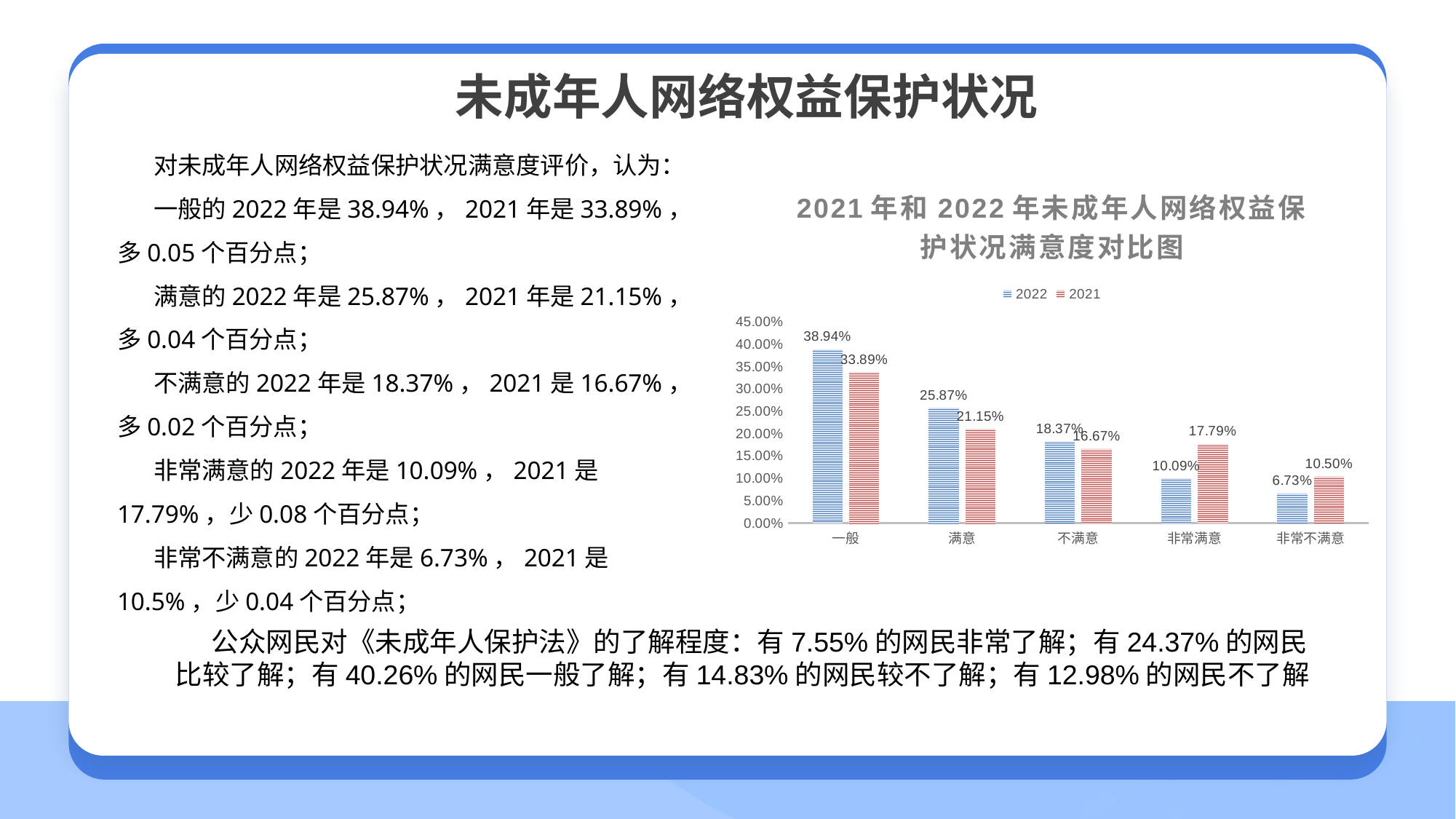
What is the difference between the 2022 and 2021 values for 满意? 4.72% What kind of chart is shown on the slide? bar chart What is the 2021 value for 非常不满意 in the chart? 10.50% How many categories are shown on the x axis of the chart? 5 Is the 2022 value for 不满意 greater or less than 15.00%? greater Which category has the lowest 2021 value in the chart? 非常不满意 What is the 2021 value for 非常满意 in the chart? 17.79% How many series does the chart legend list? 2 For 非常满意, which year has the larger value, 2022 or 2021? 2021 What is the 2022 value for 一般 in the chart? 38.94% Which category has the highest 2022 value in the chart? 一般 Which series is shown in blue in the chart? 2022